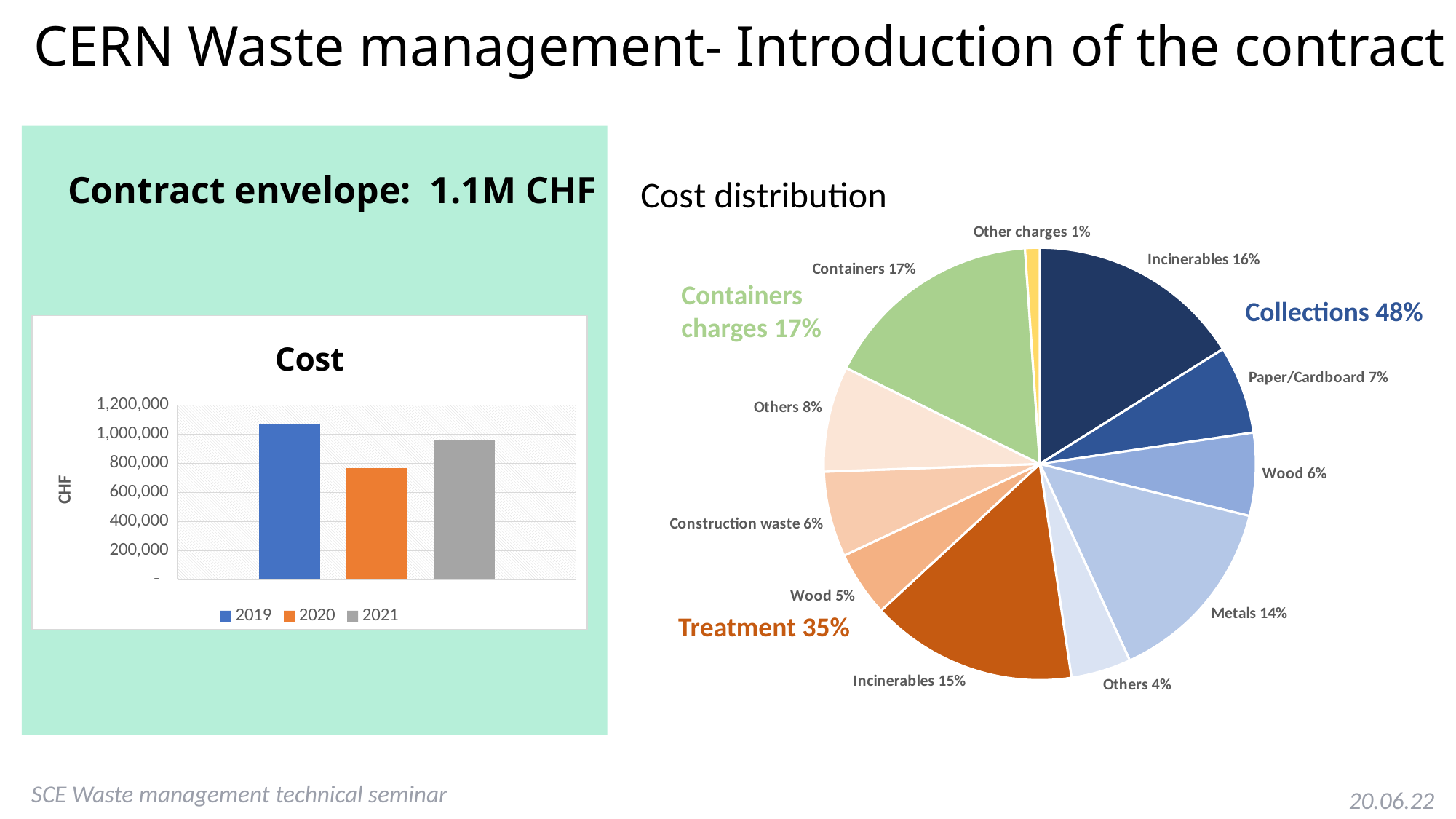
What kind of chart is the Cost chart on the left? bar chart In the Cost bar chart, is the value for 2021 greater or less than 1,000,000? less In the Cost distribution pie chart, what share does Metals have? 14% In the Cost bar chart, is the value for 2020 greater or less than 800,000? less In the Cost distribution pie chart, what share does Paper/Cardboard have? 7% In the Cost distribution pie chart, which is larger: Metals or Construction waste? Metals In the Cost bar chart, which year has the highest cost? 2019 In the Cost bar chart, how many years does the legend list? 3 In the Cost bar chart, which year has the lowest cost? 2020 In the Cost distribution pie chart, what is the difference between the Collections share and the Treatment share? 13% In the Cost bar chart, is the value for 2019 greater or less than 1,000,000? greater In the Cost distribution pie chart, which slice is the smallest? Other charges 1%